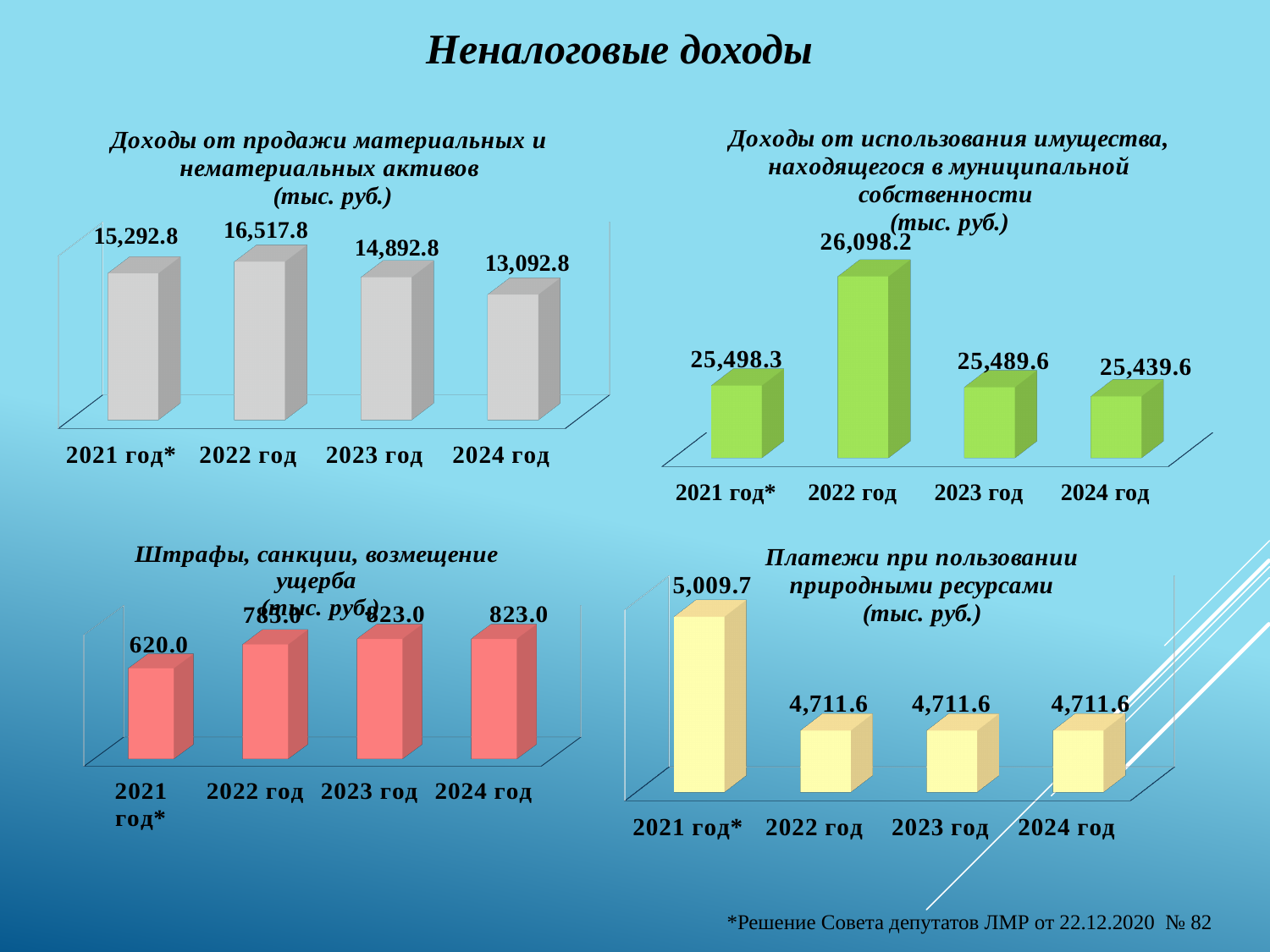
In the chart 'Доходы от продажи материальных и нематериальных активов', which year has the lowest value? 2024 год In the chart 'Платежи при пользовании природными ресурсами', what is the value for 2021 год*? 5,009.7 In the chart 'Доходы от использования имущества, находящегося в муниципальной собственности', which year has the highest value? 2022 год In the chart 'Доходы от продажи материальных и нематериальных активов', what is the value for 2022 год? 16,517.8 In the chart 'Штрафы, санкции, возмещение ущерба', what is the value for 2021 год*? 620.0 How many charts are shown on the slide? 4 In the chart 'Доходы от использования имущества, находящегося в муниципальной собственности', what is the value for 2024 год? 25,439.6 In the chart 'Доходы от использования имущества, находящегося в муниципальной собственности', what is the difference between the 2022 год and 2021 год* values? 599.9 In the chart 'Штрафы, санкции, возмещение ущерба', what is the value for 2024 год? 823.0 In the chart 'Платежи при пользовании природными ресурсами', which is larger, the value for 2021 год* or 2022 год? 2021 год* In the chart 'Доходы от продажи материальных и нематериальных активов', what is the difference between the 2022 год and 2024 год values? 3,425.0 What kind of chart is 'Платежи при пользовании природными ресурсами'? bar chart